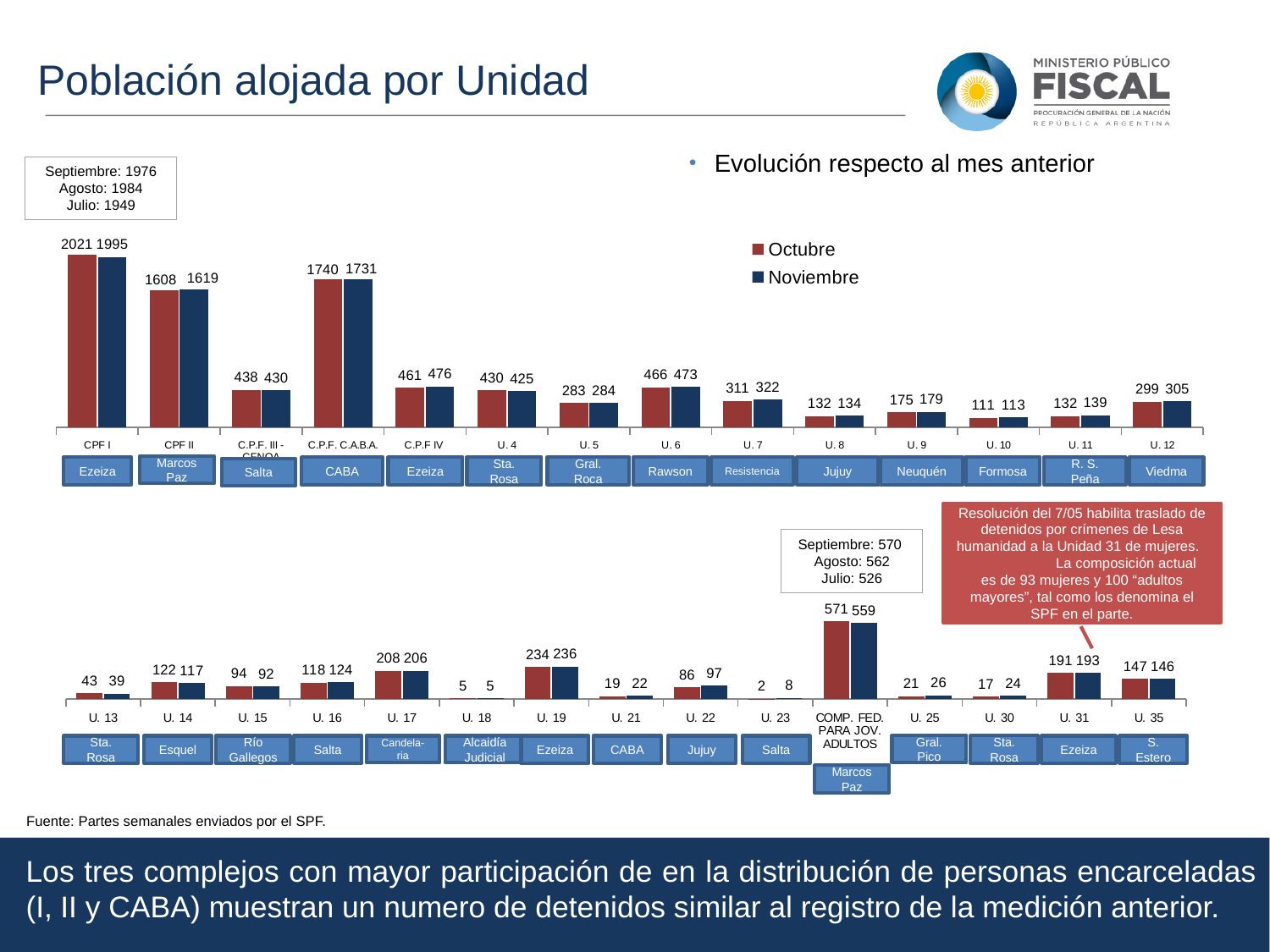
What type of chart is the top chart? Bar chart In the bottom chart, which category has the lowest Octubre value? U. 23 In the top chart, which category has the highest Octubre value? CPF I In the top chart, which is larger for U. 7: the Octubre value or the Noviembre value? Noviembre What are the two series named in the legend? Octubre and Noviembre In the top chart, what is the Octubre value for C.P.F. C.A.B.A.? 1740 In the top chart, what is the difference between the Octubre and Noviembre values for CPF I? 26 How many series does the legend list? 2 In the bottom chart, what is the Noviembre value for U. 22? 97 In the bottom chart, what is the difference between the Octubre and Noviembre values for COMP. FED. PARA JOV. ADULTOS? 12 How many categories are shown on the x axis of the bottom chart? 15 In the top chart, what is the Noviembre value for CPF I? 1995